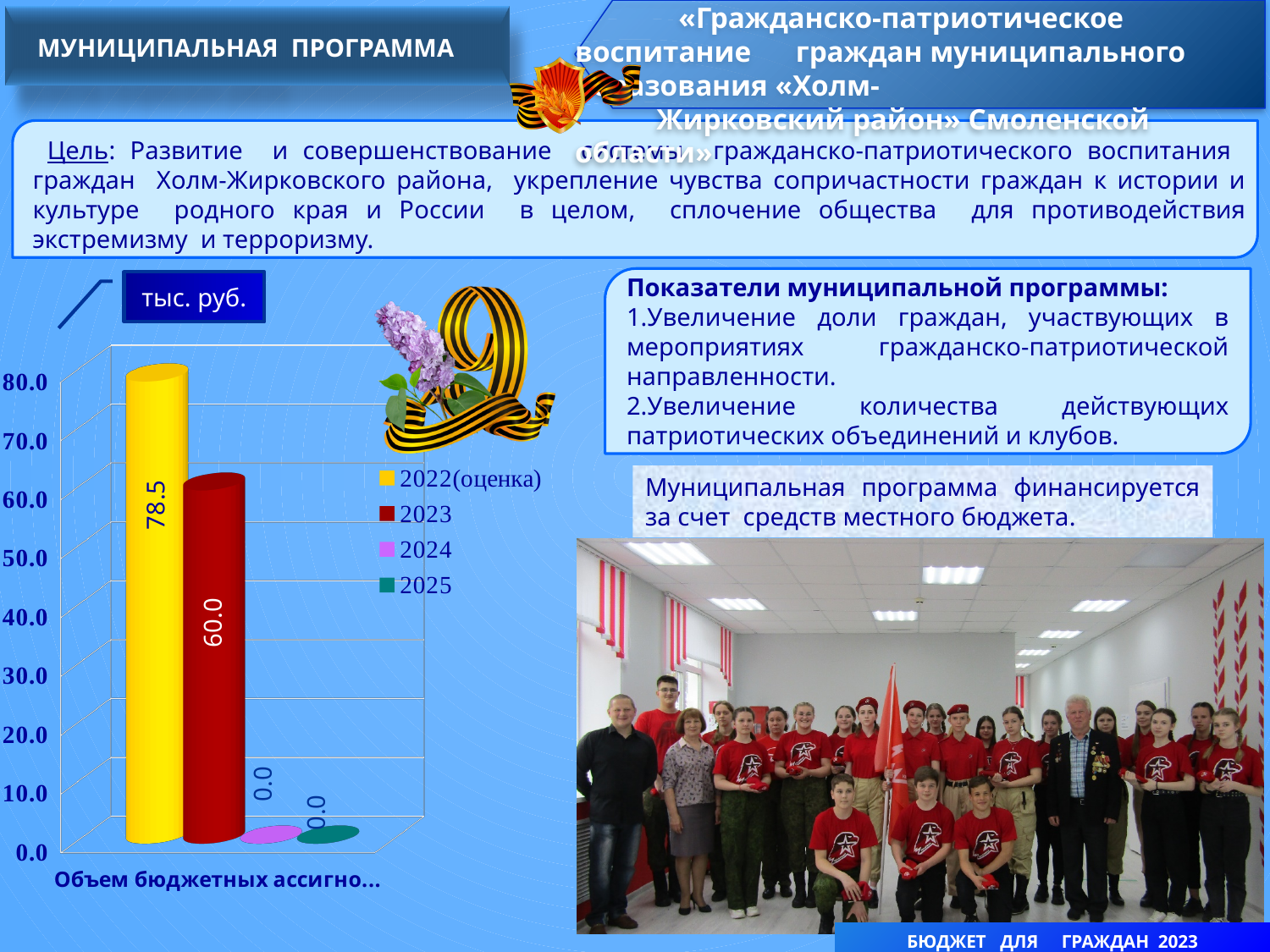
What is the value for 2023 in the chart? 60.0 What is the difference between the values for 2022(оценка) and 2023? 18.5 What is the value for 2025 in the chart? 0.0 Is the value for 2022(оценка) greater or less than 70.0? greater Is the value for 2023 greater or less than 70.0? less What kind of chart is shown on the slide? bar chart Which is larger, the value for 2022(оценка) or the value for 2023? 2022(оценка) What unit is shown in the box above the chart? тыс. руб. What is the value for 2024 in the chart? 0.0 Which series has the highest value in the chart? 2022(оценка) How many series does the chart legend list? 4 What is the value for 2022(оценка) in the chart? 78.5